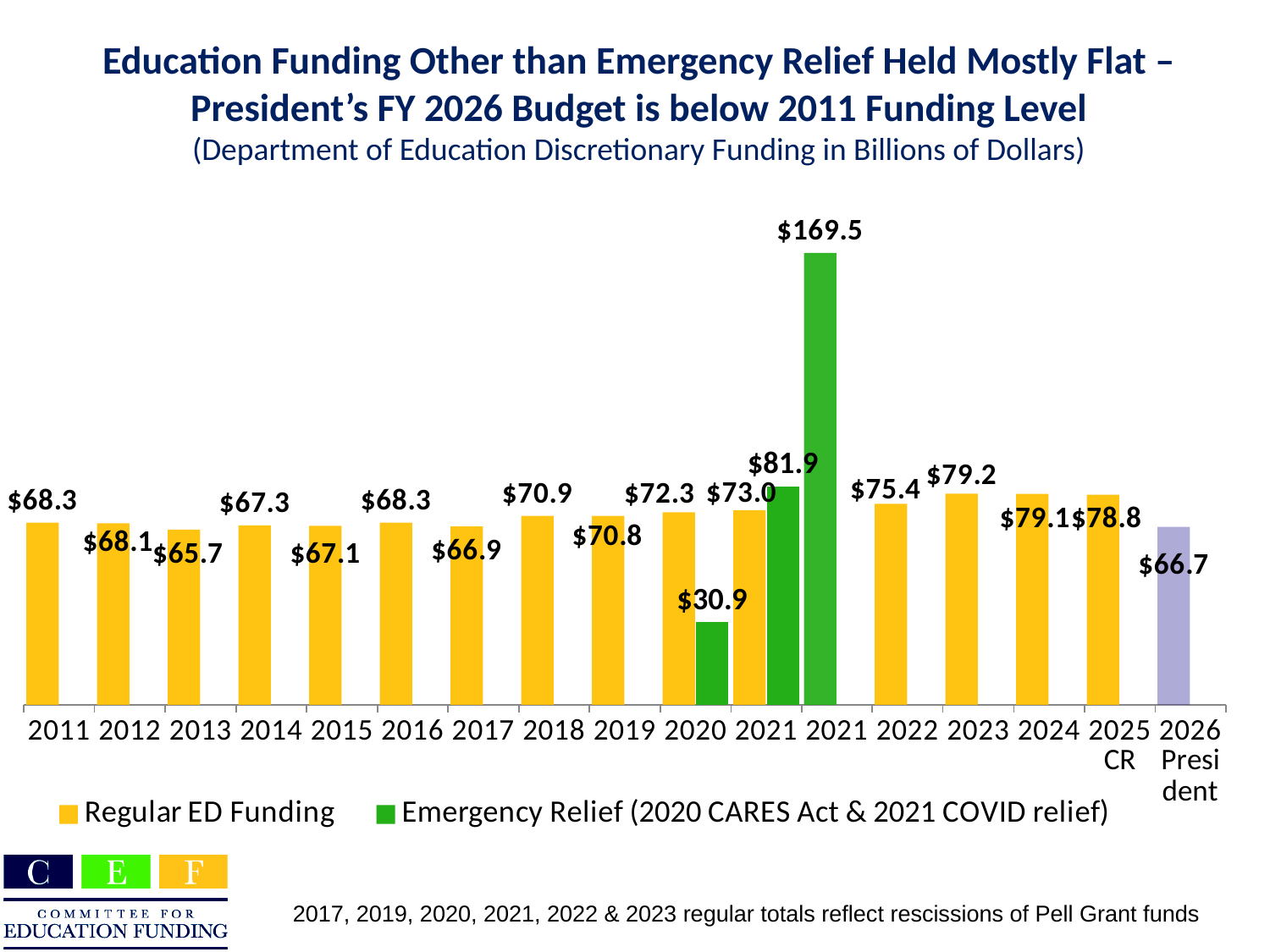
What is the difference between the Regular ED Funding for 2023 and the 2026 President value? $12.5 What is the largest Emergency Relief value shown on the chart? $169.5 What is the Emergency Relief value shown for 2020? $30.9 What is the difference between the two Emergency Relief bars labeled 2021? $87.6 How many categories are shown along the x axis? 17 How many series does the legend list? 2 What is the Regular ED Funding value for 2011? $68.3 What is the value of the 2026 President bar? $66.7 What kind of chart is shown on the slide? Bar chart Which is larger, the Regular ED Funding for 2022 or for 2025 CR? 2025 CR Which year has the lowest Regular ED Funding value? 2013 Which year has the highest Regular ED Funding value? 2023